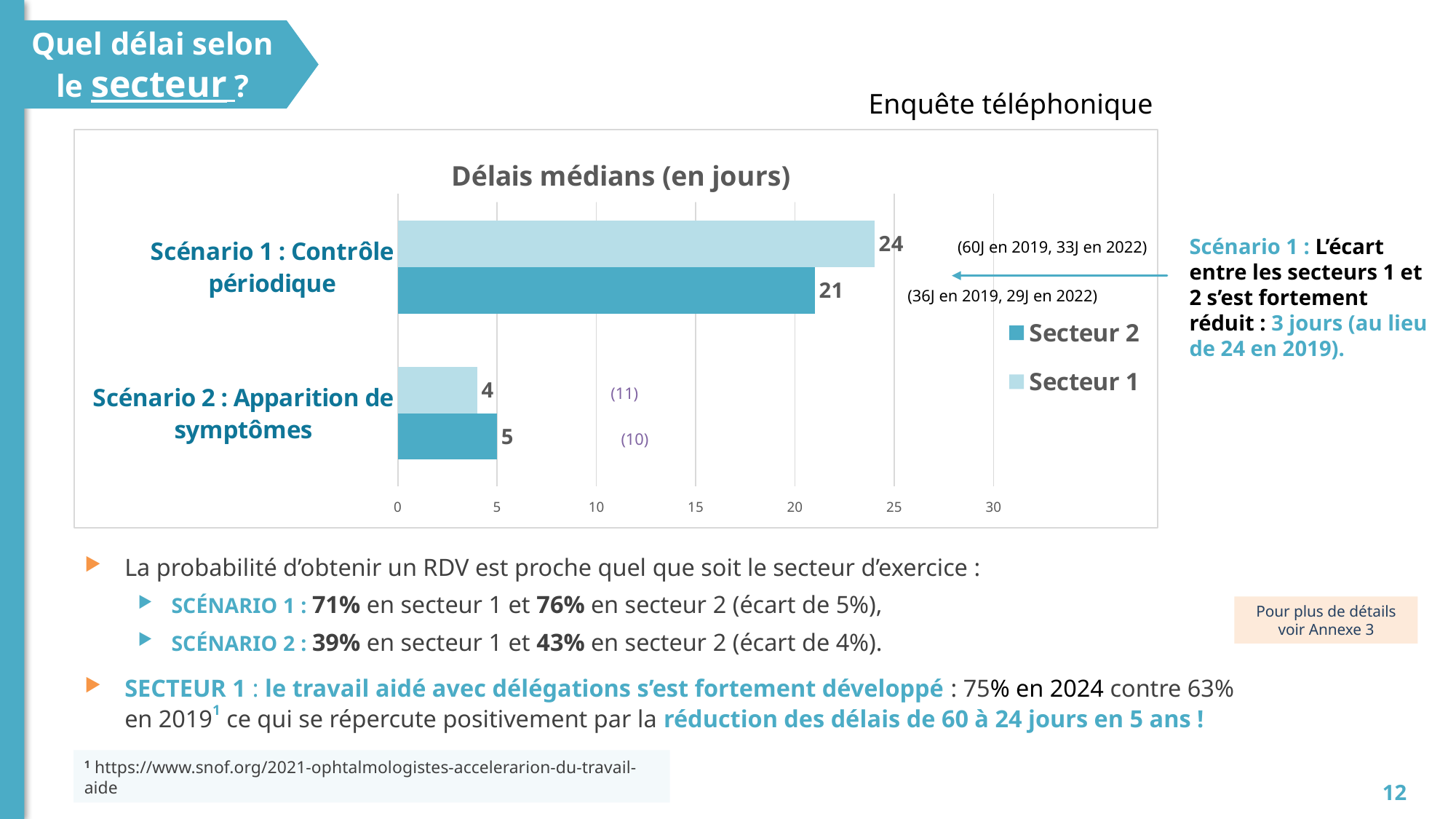
What is the median delay for Secteur 2 in Scénario 1 : Contrôle périodique? 21 In Scénario 2 : Apparition de symptômes, which sector has the larger median delay, Secteur 1 or Secteur 2? Secteur 2 What is the difference between the Secteur 1 and Secteur 2 median delays in Scénario 1 : Contrôle périodique? 3 What type of chart is shown on the slide? bar chart What is the median delay for Secteur 1 in Scénario 1 : Contrôle périodique? 24 Is the Secteur 2 value for Scénario 1 : Contrôle périodique greater or less than 25? less Which scenario has the lowest median delay for Secteur 2? Scénario 2 : Apparition de symptômes How many series does the chart legend list? 2 What is the median delay for Secteur 2 in Scénario 2 : Apparition de symptômes? 5 Which scenario has the highest median delay for Secteur 1? Scénario 1 : Contrôle périodique How many scenarios are shown on the chart? 2 What is the median delay for Secteur 1 in Scénario 2 : Apparition de symptômes? 4